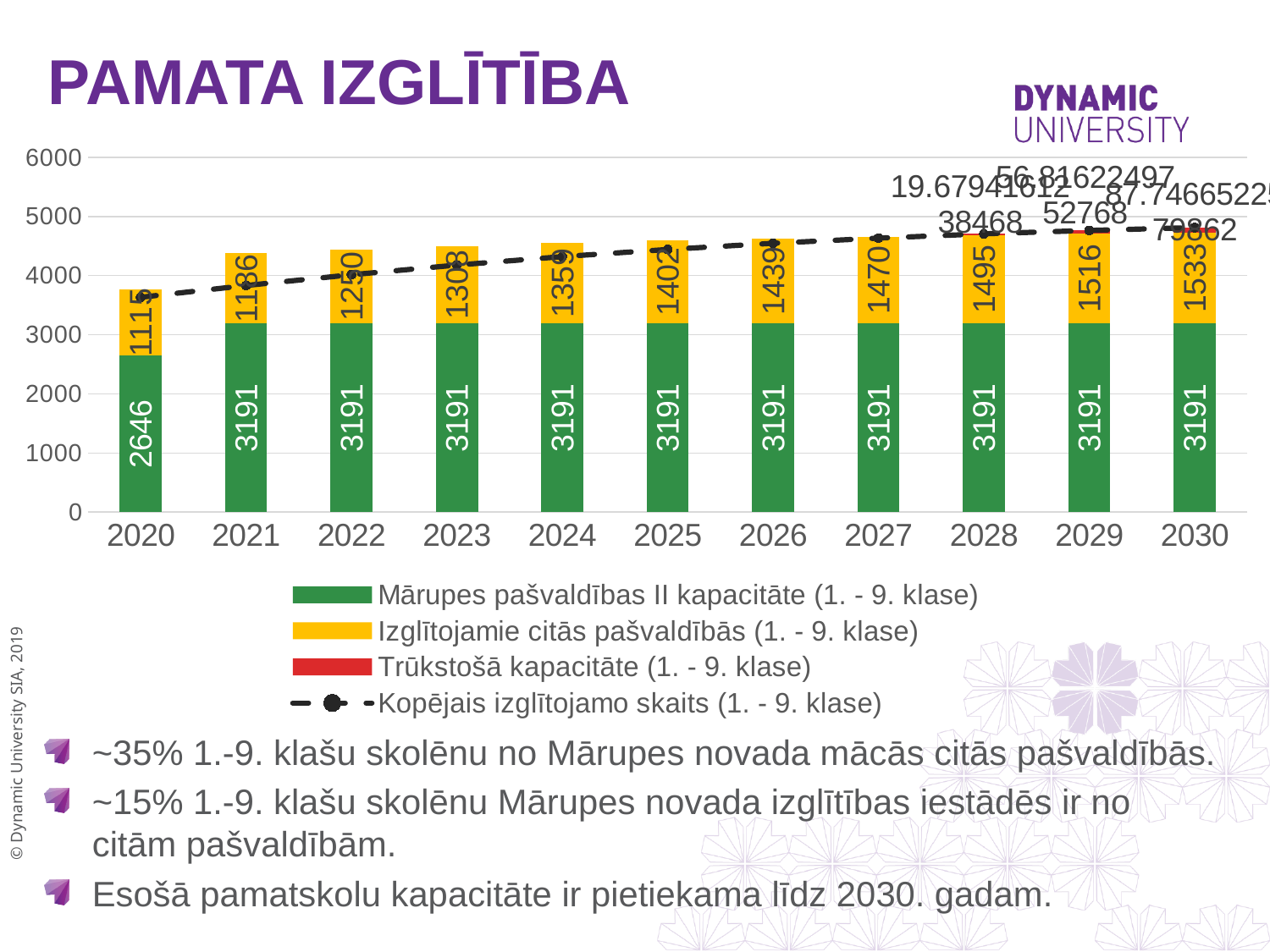
How many series does the legend list? 4 Which year has the larger value for Izglītojamie citās pašvaldībās (1. - 9. klase), 2024 or 2026? 2026 What is the total of the stacked bar for 2020? 3761 What is the value of Izglītojamie citās pašvaldībās (1. - 9. klase) for 2030? 1533 How many years are shown on the x axis? 11 What is the value of Mārupes pašvaldības II kapacitāte (1. - 9. klase) for 2020? 2646 In which year is Izglītojamie citās pašvaldībās (1. - 9. klase) highest? 2030 In which year is Izglītojamie citās pašvaldībās (1. - 9. klase) lowest? 2020 What kind of chart is shown on the slide? Combination stacked bar and line chart What is the value of Mārupes pašvaldības II kapacitāte (1. - 9. klase) for 2027? 3191 What is the value of Izglītojamie citās pašvaldībās (1. - 9. klase) for 2025? 1402 What is the difference between Izglītojamie citās pašvaldībās (1. - 9. klase) in 2030 and in 2020? 418